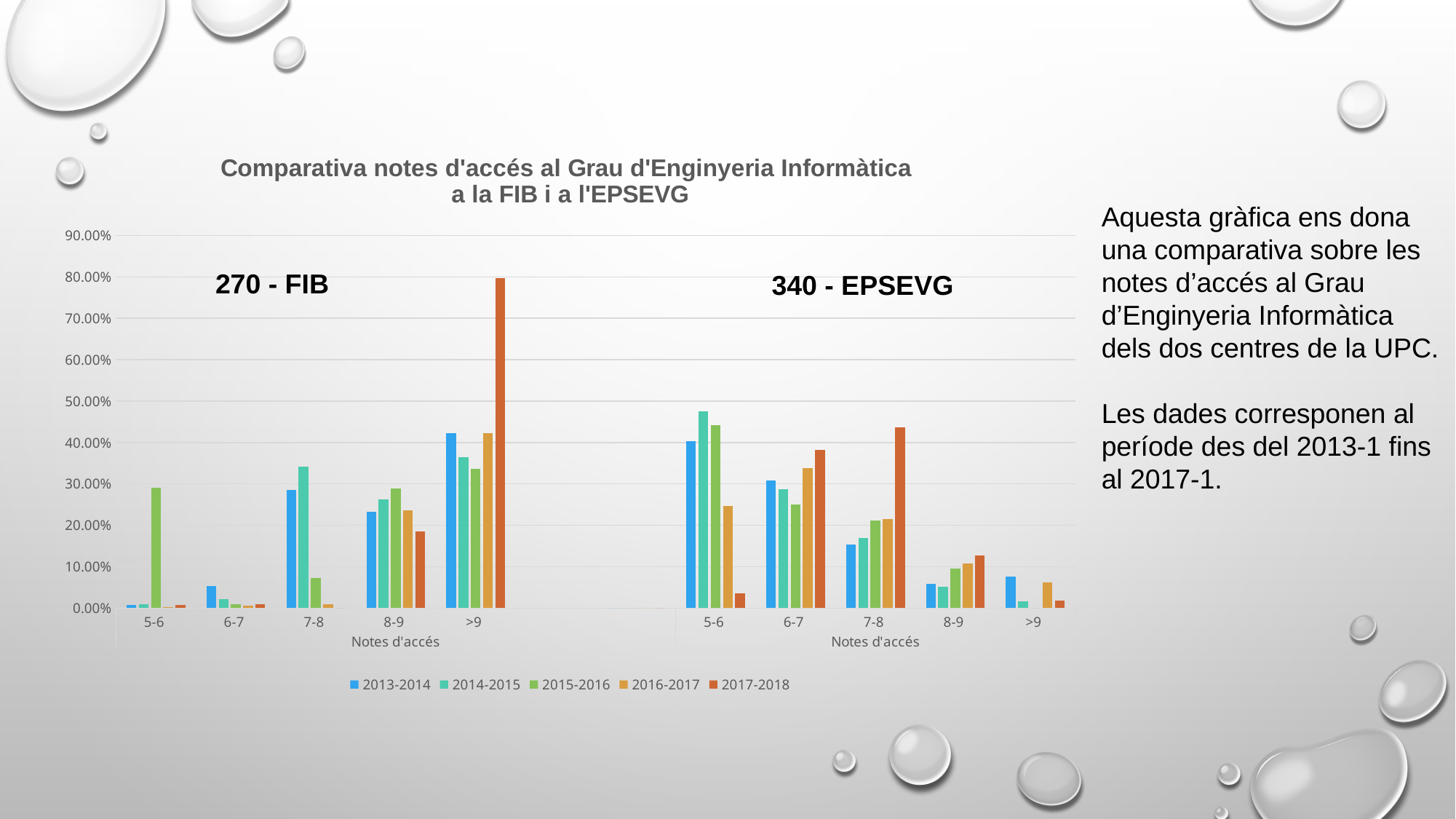
In the 340 - EPSEVG group, for the 7-8 category, which is larger: the 2013-2014 value or the 2017-2018 value? 2017-2018 In the 270 - FIB group, for the 7-8 category, which is larger: the 2014-2015 value or the 2015-2016 value? 2014-2015 In the 270 - FIB group, is the 2017-2018 value for >9 greater or less than 70%? greater What kind of chart is shown on the slide? bar chart In the 270 - FIB group, is the 2015-2016 value for 5-6 greater or less than 20%? greater In the 340 - EPSEVG group, which series has the lowest bar for the 5-6 category? 2017-2018 In the 340 - EPSEVG group, is the 2014-2015 value for 5-6 greater or less than 40%? greater How many series does the legend list? 5 In the 270 - FIB group, which series has the tallest bar for the >9 category? 2017-2018 What is the label of the x axis under each group of bars? Notes d'accés How many grade categories are shown on the x axis for the 270 - FIB group? 5